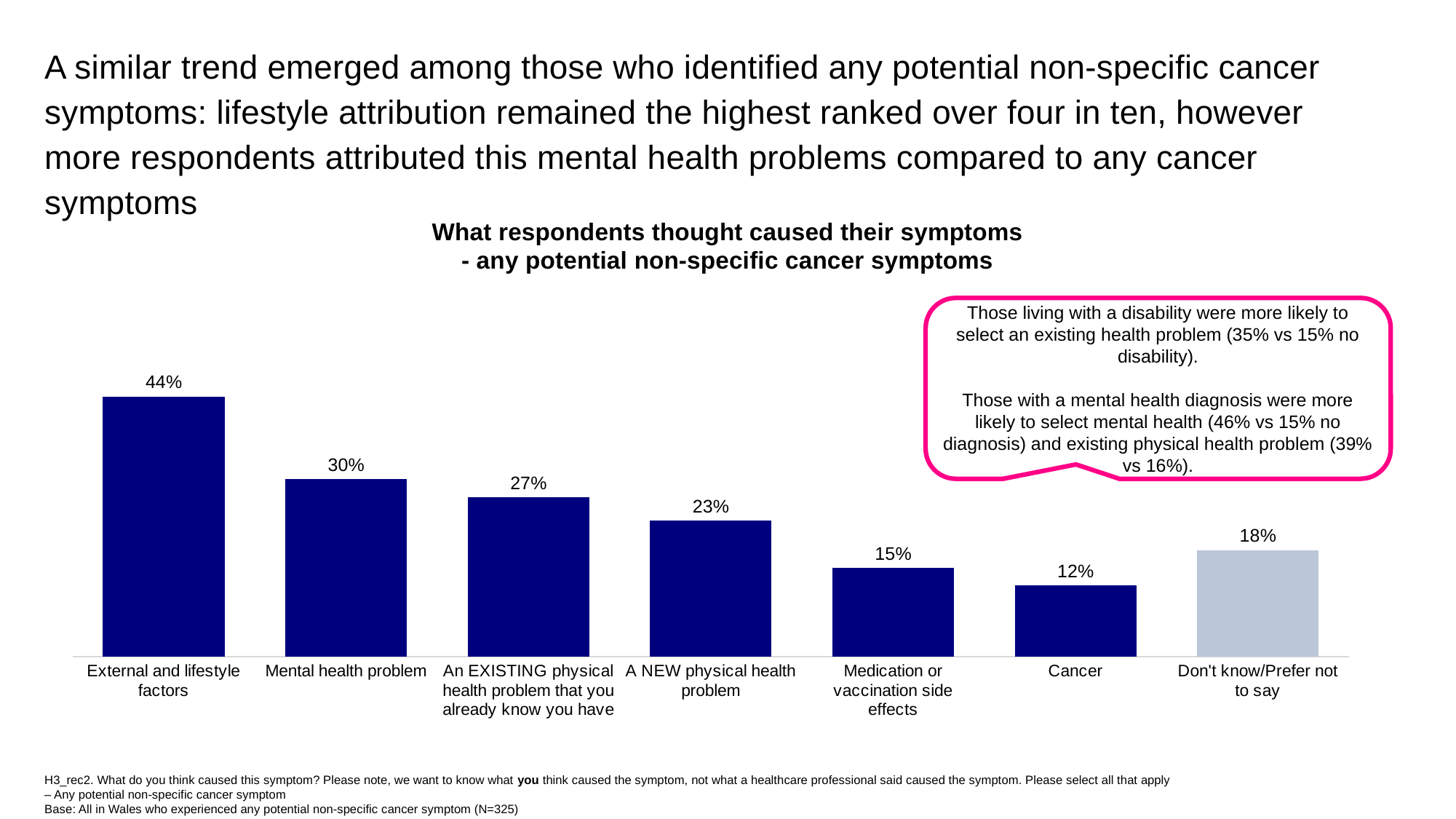
How many categories are shown in the chart? 7 What type of chart is shown on the slide? Bar chart Which is larger: the value for An EXISTING physical health problem that you already know you have or the value for Don't know/Prefer not to say? An EXISTING physical health problem that you already know you have Which bar is shown in a different (light grey-blue) colour from the others? Don't know/Prefer not to say What is the difference between the values for External and lifestyle factors and Mental health problem? 14 percentage points What value is shown for Don't know/Prefer not to say? 18% Which category has the highest value? External and lifestyle factors Which category has the lowest value? Cancer What percentage of respondents attributed their symptoms to external and lifestyle factors? 44% What value is shown for Mental health problem? 30% What is the difference between the values for A NEW physical health problem and Medication or vaccination side effects? 8 percentage points What percentage of respondents selected Cancer as the cause of their symptoms? 12%